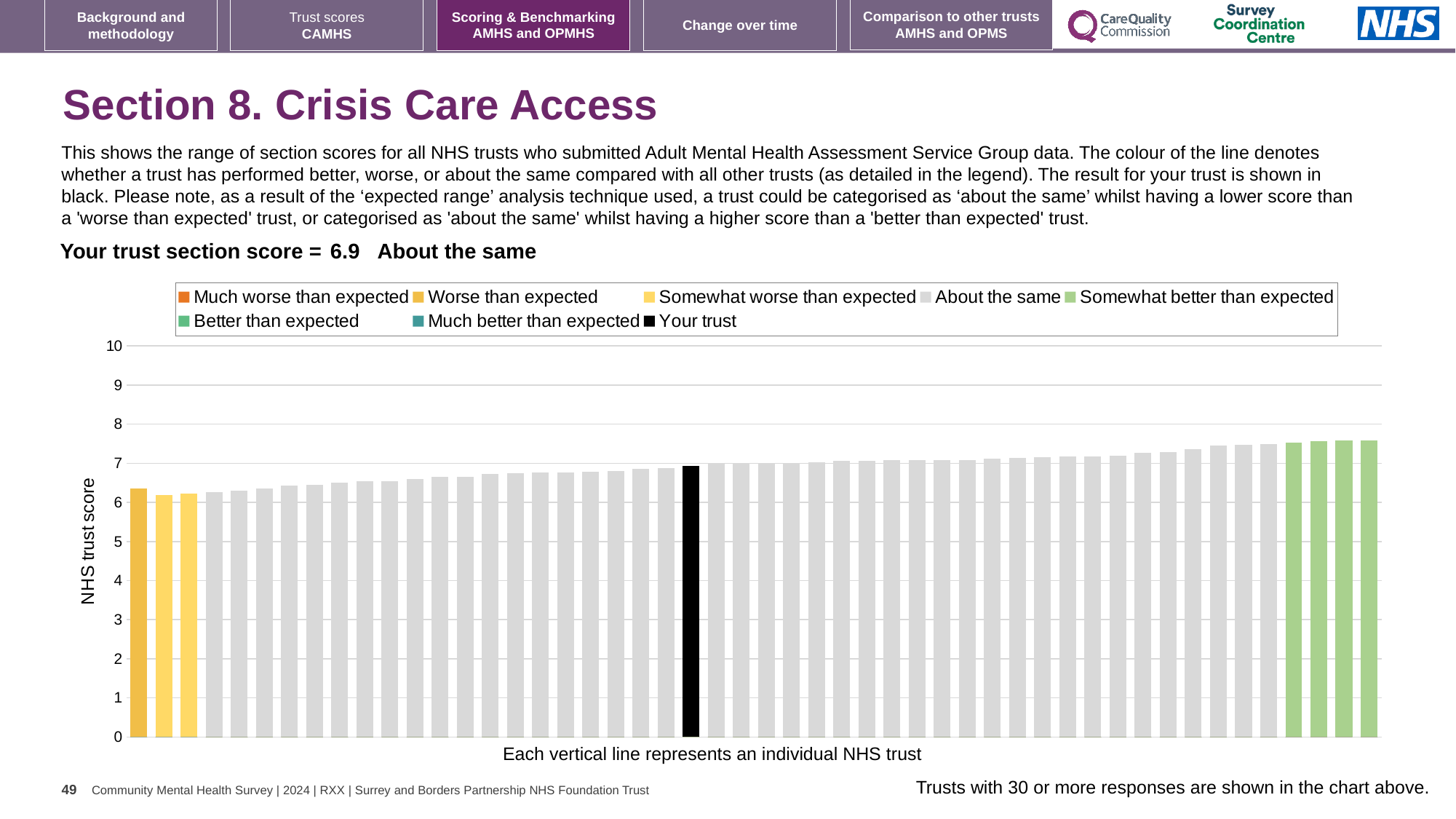
What colour is the bar representing your trust? black What is the section score for your trust shown on the slide? 6.9 Which category is your trust placed in according to the slide? About the same How many bars are coloured green (Somewhat better than expected)? 4 Is the value for your trust (the black bar) greater or less than 5? greater Is the highest bar in the chart greater or less than 8? less Is the lowest bar in the chart greater or less than 5? greater Which is larger: the black bar for your trust or the orange bar at the far left? the black bar for your trust What is the label on the vertical axis of the chart? NHS trust score How many entries does the chart legend list? 8 Do the bar values rise or fall from left to right along the x axis? rise What kind of chart is shown on the slide? bar chart